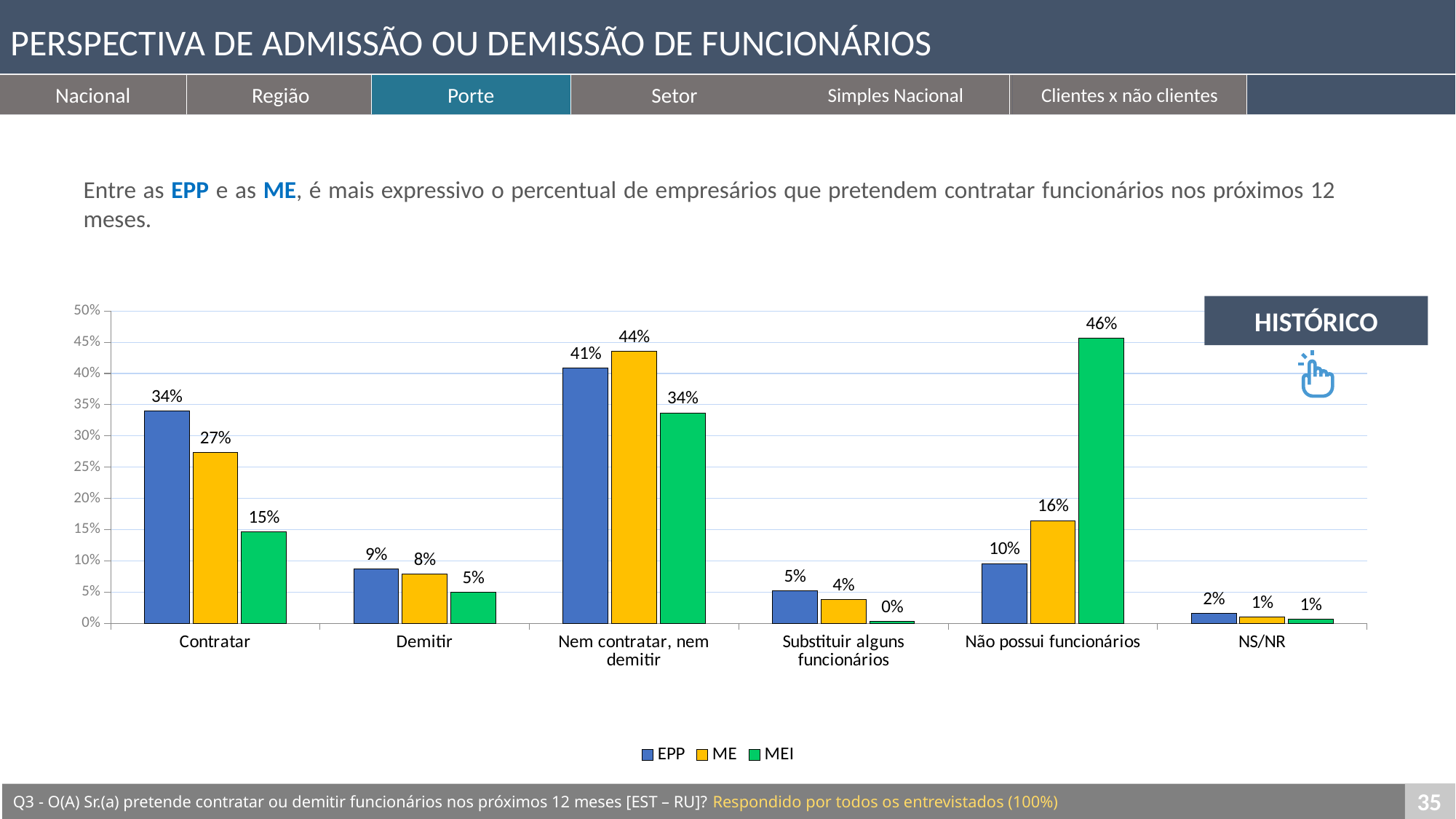
What kind of chart is shown on the slide? bar chart What is the value for MEI in the Não possui funcionários category? 46% Which is larger in the Demitir category, the EPP value or the MEI value? EPP How many series does the legend list? 3 Which series is shown in green in the legend? MEI What is the difference between the EPP and MEI values in the Contratar category? 19% How many categories are shown on the x axis? 6 Which category has the lowest value for the EPP series? NS/NR Which category has the highest value for the MEI series? Não possui funcionários What is the value for EPP in the Contratar category? 34% Is the value for ME in the Não possui funcionários category greater or less than 20%? less What is the value for ME in the Nem contratar, nem demitir category? 44%